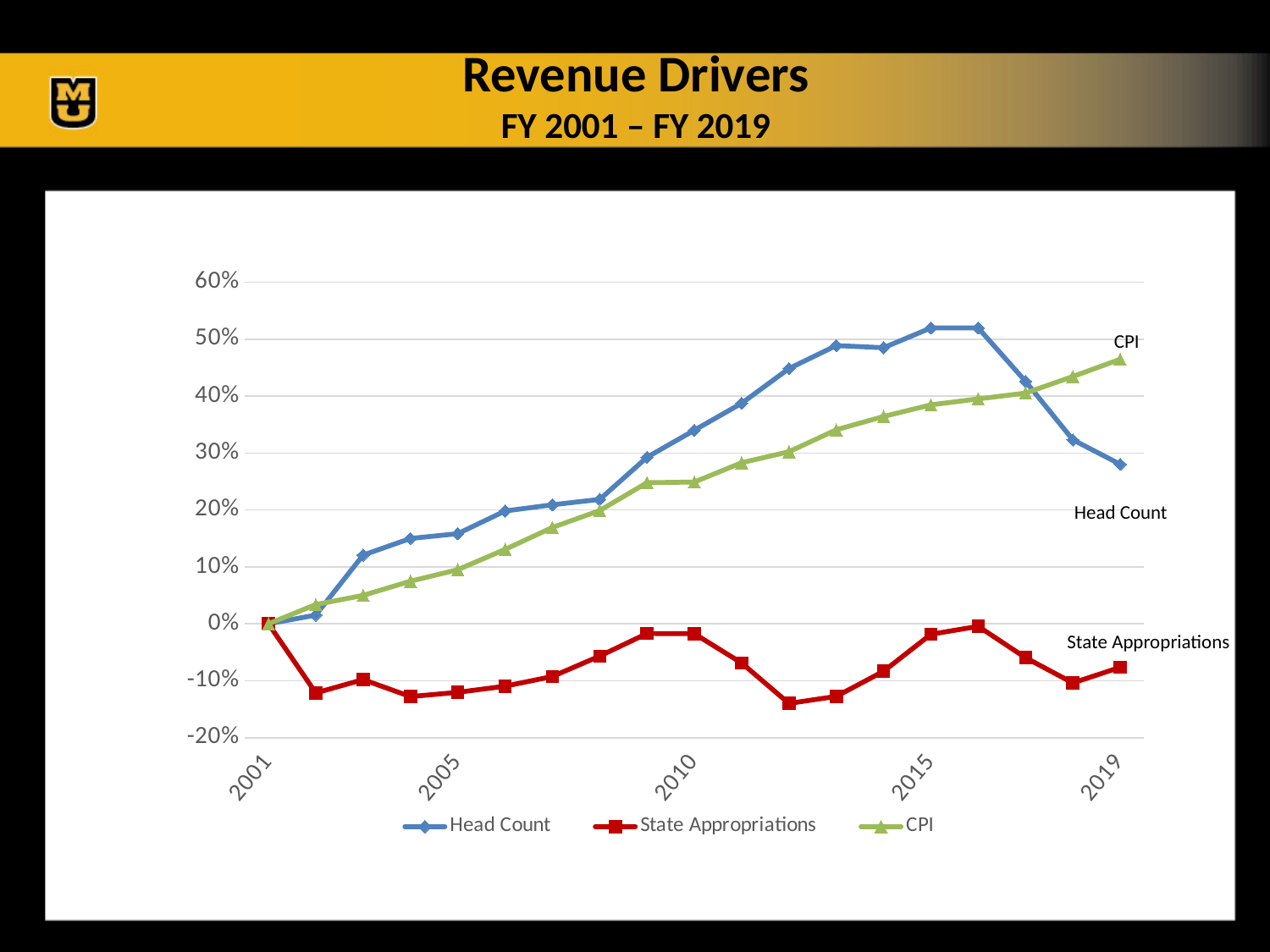
What is the value of the Head Count series in 2001? 0% In 2010, which series is higher, Head Count or CPI? Head Count What are the three series named in the legend? Head Count, State Appropriations, CPI Does the CPI series rise or fall from 2001 to 2019? Rise How many yearly data points does each series have on the chart? 19 Is the value for Head Count in 2016 greater or less than 40%? greater Is the value for State Appropriations in 2012 greater or less than -10%? less Is the value for CPI in 2019 greater or less than 40%? greater In 2019, which series is higher, CPI or Head Count? CPI What kind of chart is shown on the slide? Line chart How many series does the legend list? 3 Which series has the lowest value in 2019? State Appropriations